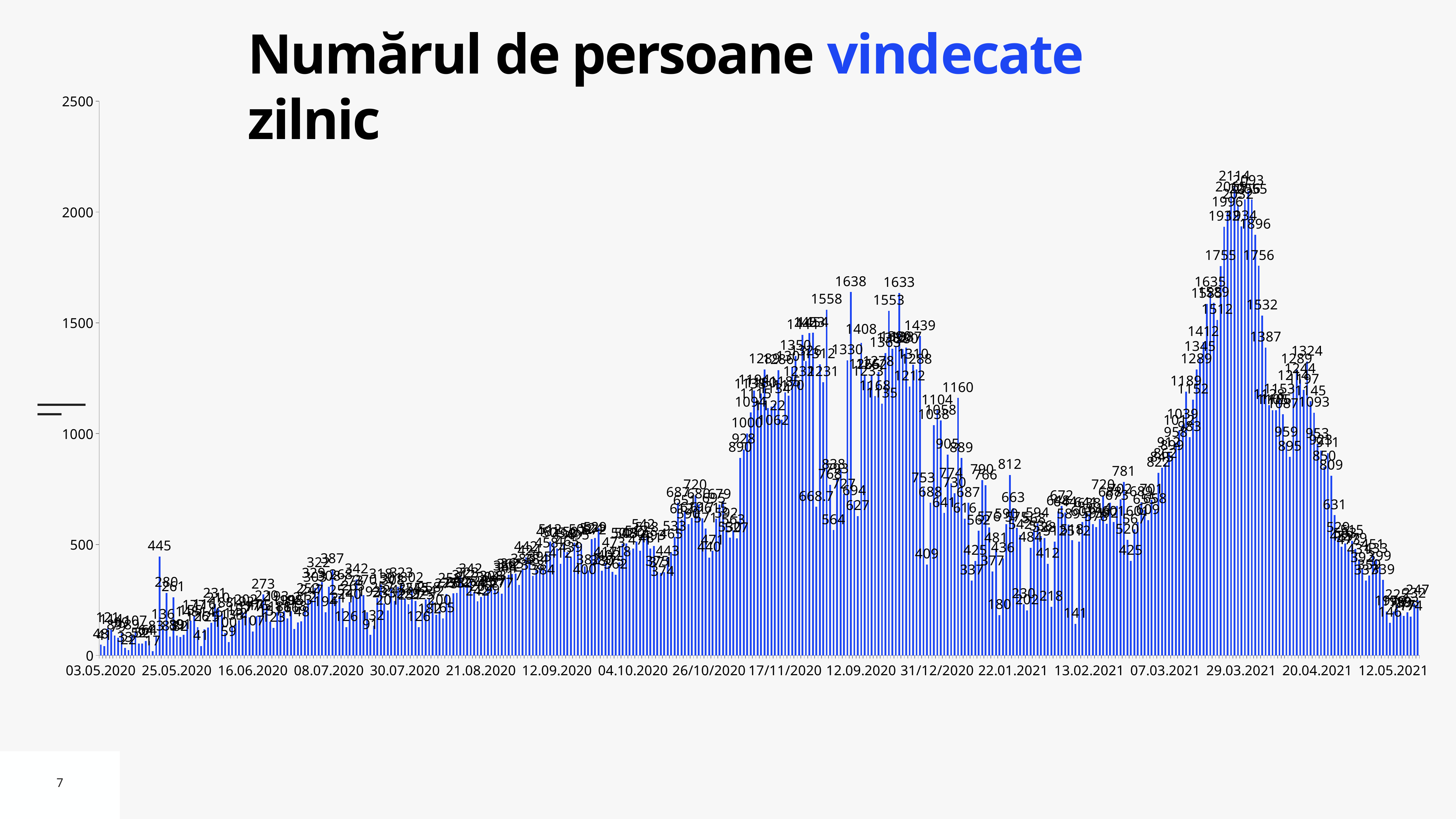
What is the title of the chart? Numărul de persoane vindecate zilnic What is the highest value shown on the vertical axis? 2500 Do the values rise or fall between 07.03.2021 and 29.03.2021? rise Is the highest bar on the chart greater or less than 2000? greater Do the values rise or fall between 29.03.2021 and 12.05.2021? fall Which peak is higher: the one around 17/11/2020 or the one around 29.03.2021? the one around 29.03.2021 Is the value at the start of the chart, around 03.05.2020, greater or less than 500? less What type of chart is shown on the slide? bar chart What is the last date label on the horizontal axis? 12.05.2021 What is the difference between the highest value of the March 2021 peak (2114) and the highest value of the November 2020 peak (1638)? 476 What is the highest value labeled on the chart? 2114 What is the first date label on the horizontal axis? 03.05.2020